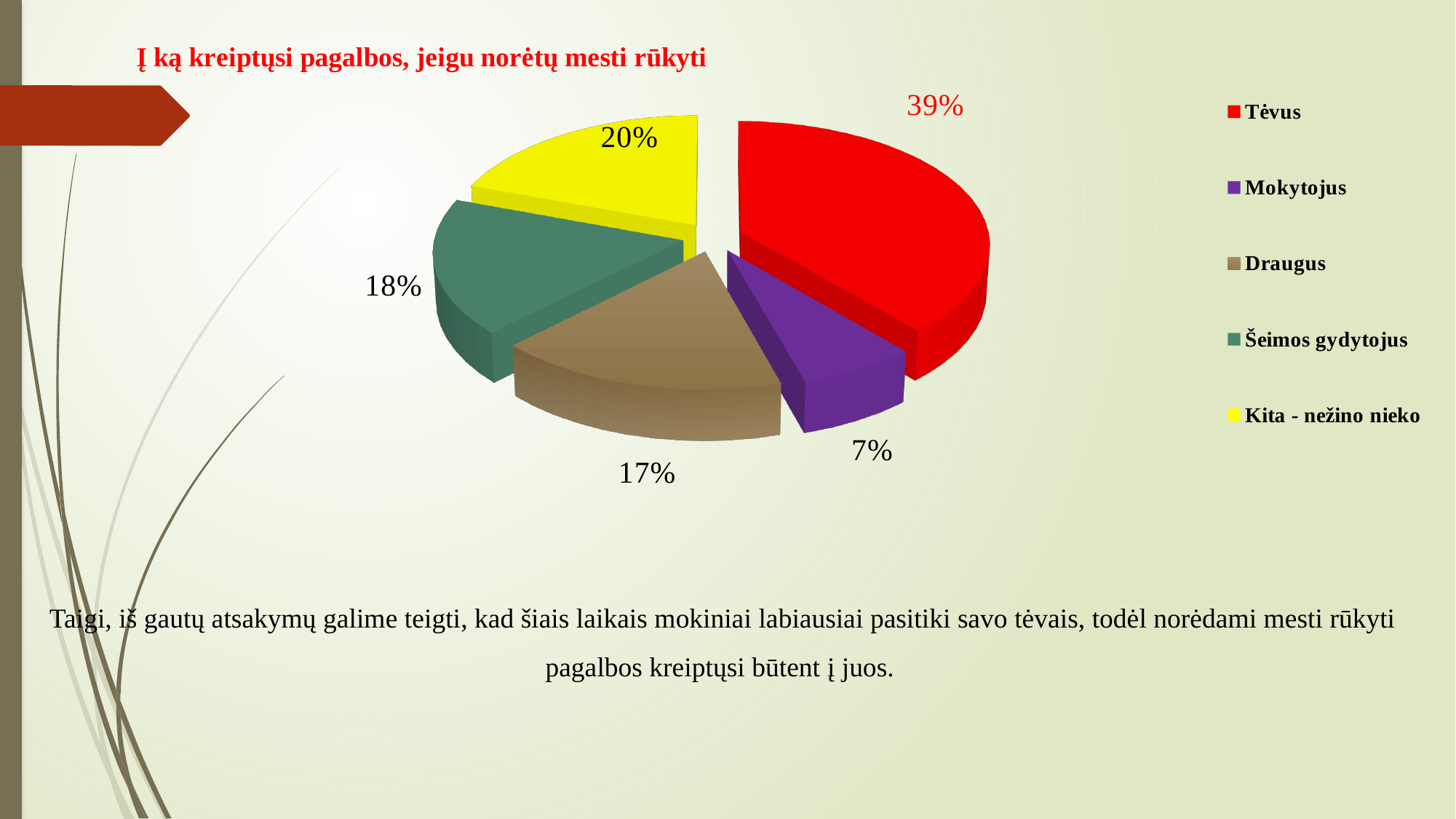
What share of the pie does Kita - nežino nieko have? 20% What is the difference in percentage points between Tėvus and Kita - nežino nieko? 19 What colour is the slice for Šeimos gydytojus? Green Which category has the largest slice of the pie? Tėvus How many slices does the pie chart have? 5 Which category has the smallest slice of the pie? Mokytojus Which is larger, the share for Draugus or the share for Kita - nežino nieko? Kita - nežino nieko What share of the pie does Draugus have? 17% What kind of chart is shown on the slide? Pie chart What share of the pie does Šeimos gydytojus have? 18%